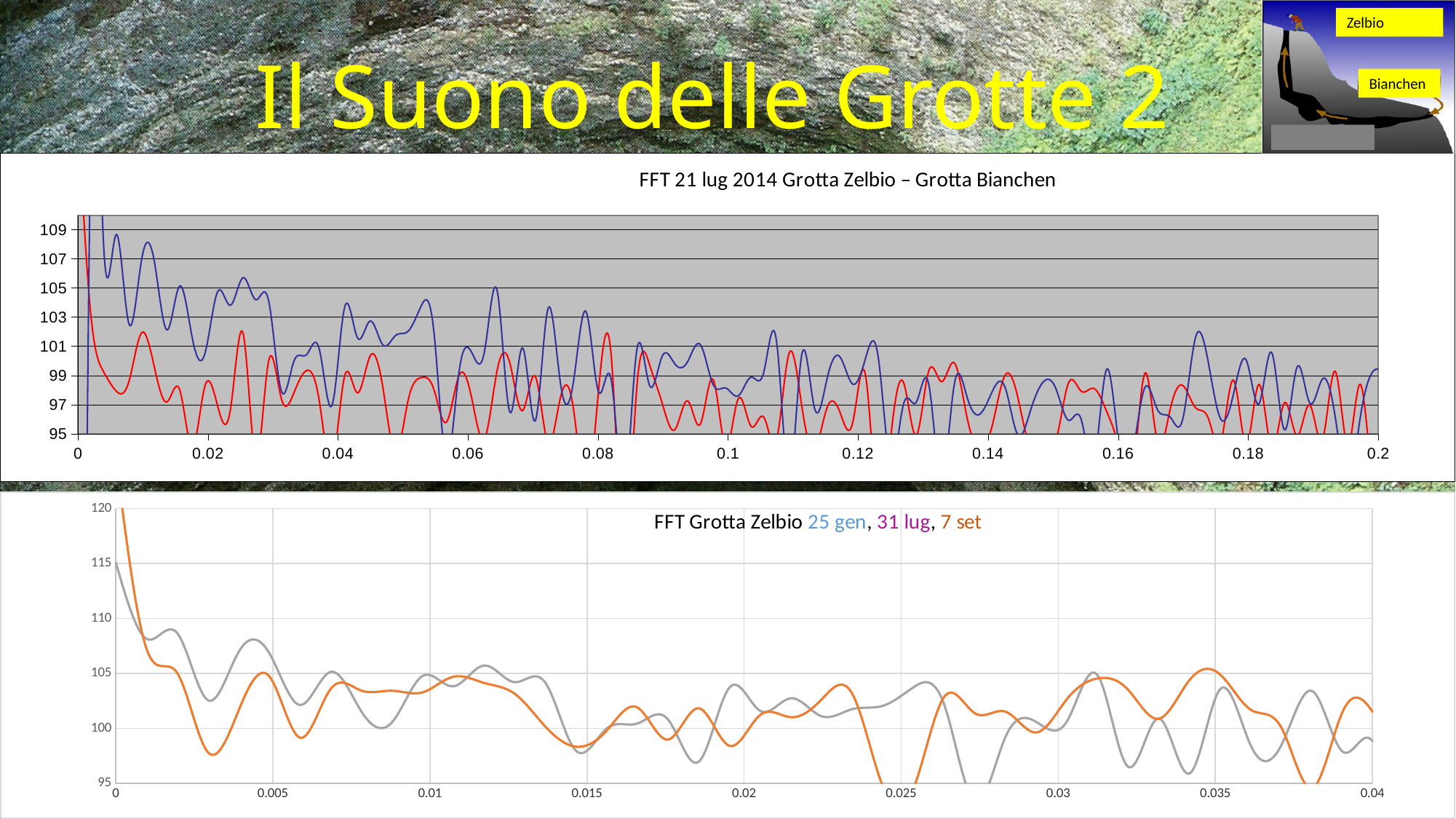
In the top chart, which line is higher at x = 0.01, the blue line or the red line? blue line In the top chart, how many lines are plotted? 2 In the bottom chart, which line is higher at x = 0.003, the grey line or the orange line? grey line In the top chart, do the values generally rise or fall as x increases from 0 to 0.2? fall What kind of chart is the top chart titled 'FFT 21 lug 2014 Grotta Zelbio – Grotta Bianchen'? line chart What is the title of the top chart? FFT 21 lug 2014 Grotta Zelbio – Grotta Bianchen What is the title of the bottom chart? FFT Grotta Zelbio 25 gen, 31 lug, 7 set In the top chart, is the value of the red line at x = 0.01 greater or less than 105? less What kind of chart is the bottom chart titled 'FFT Grotta Zelbio 25 gen, 31 lug, 7 set'? line chart In the bottom chart, is the value of the orange line at x = 0 greater or less than 115? greater In the bottom chart, is the value of the orange line at x = 0.003 greater or less than 100? less